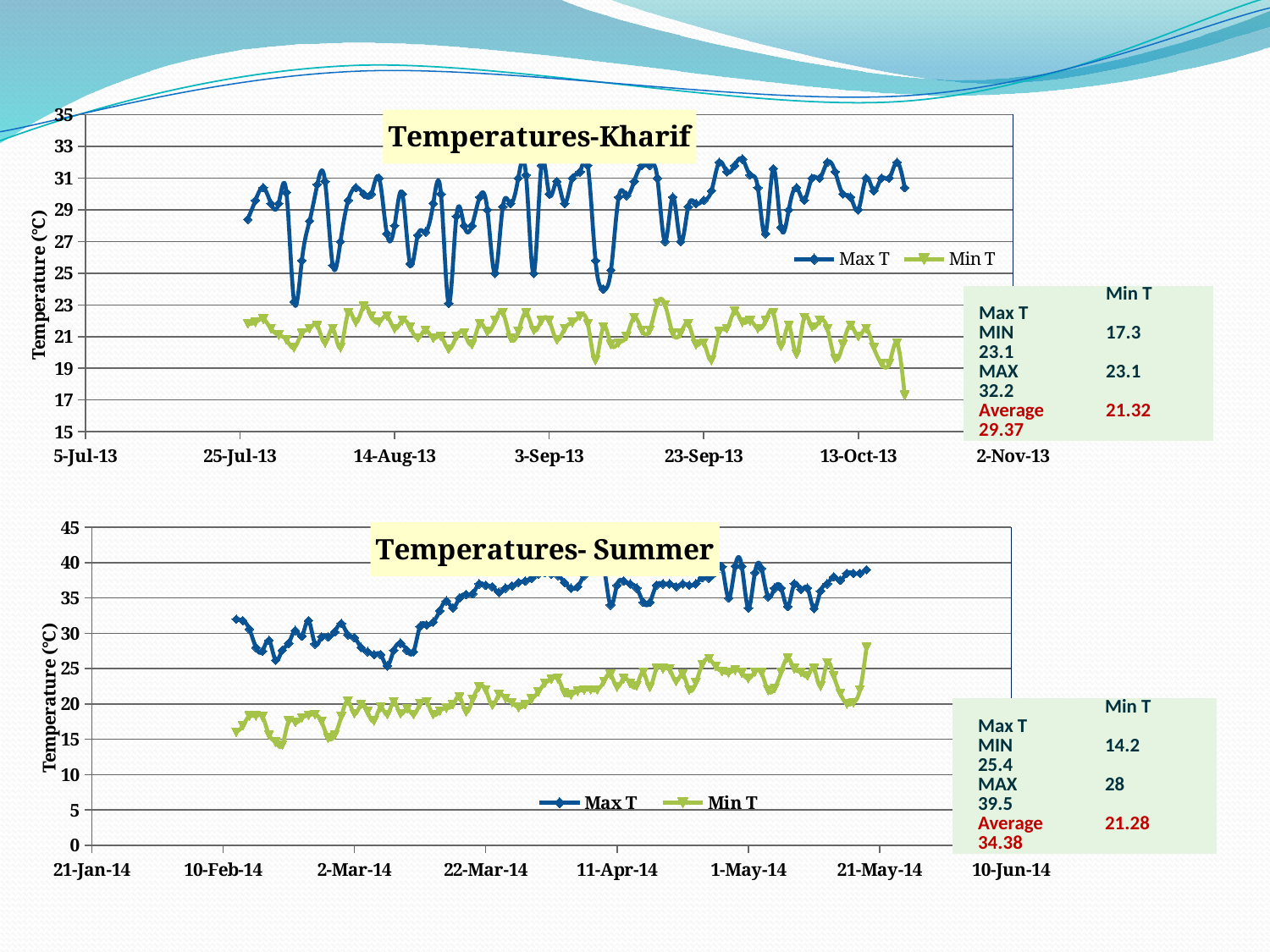
How many series does the legend of the Temperatures- Summer chart list? 2 In the Temperatures- Summer chart, is the Min T value around 10-Feb-14 greater or less than 20? less In the Temperatures- Summer chart, what is the Average value given for Max T in the statistics box? 34.38 In the Temperatures- Summer chart, what is the MAX value given for Min T in the statistics box? 28 In the Temperatures- Summer chart, what is the MIN value given for Min T in the statistics box? 14.2 In the Temperatures- Summer chart, does the Max T series generally rise or fall from February to May? rise In the Temperatures-Kharif chart, which series is plotted higher throughout, Max T or Min T? Max T In the Temperatures-Kharif chart, what is the MAX value given for Max T in the statistics box? 32.2 In the Temperatures-Kharif chart, what is the Average value given for Min T in the statistics box? 21.32 What are the two series named in the legend of the Temperatures-Kharif chart? Max T and Min T In the Temperatures- Summer chart, is the Max T value around 22-Mar-14 greater or less than 30? greater What kind of chart is the Temperatures-Kharif chart? line chart